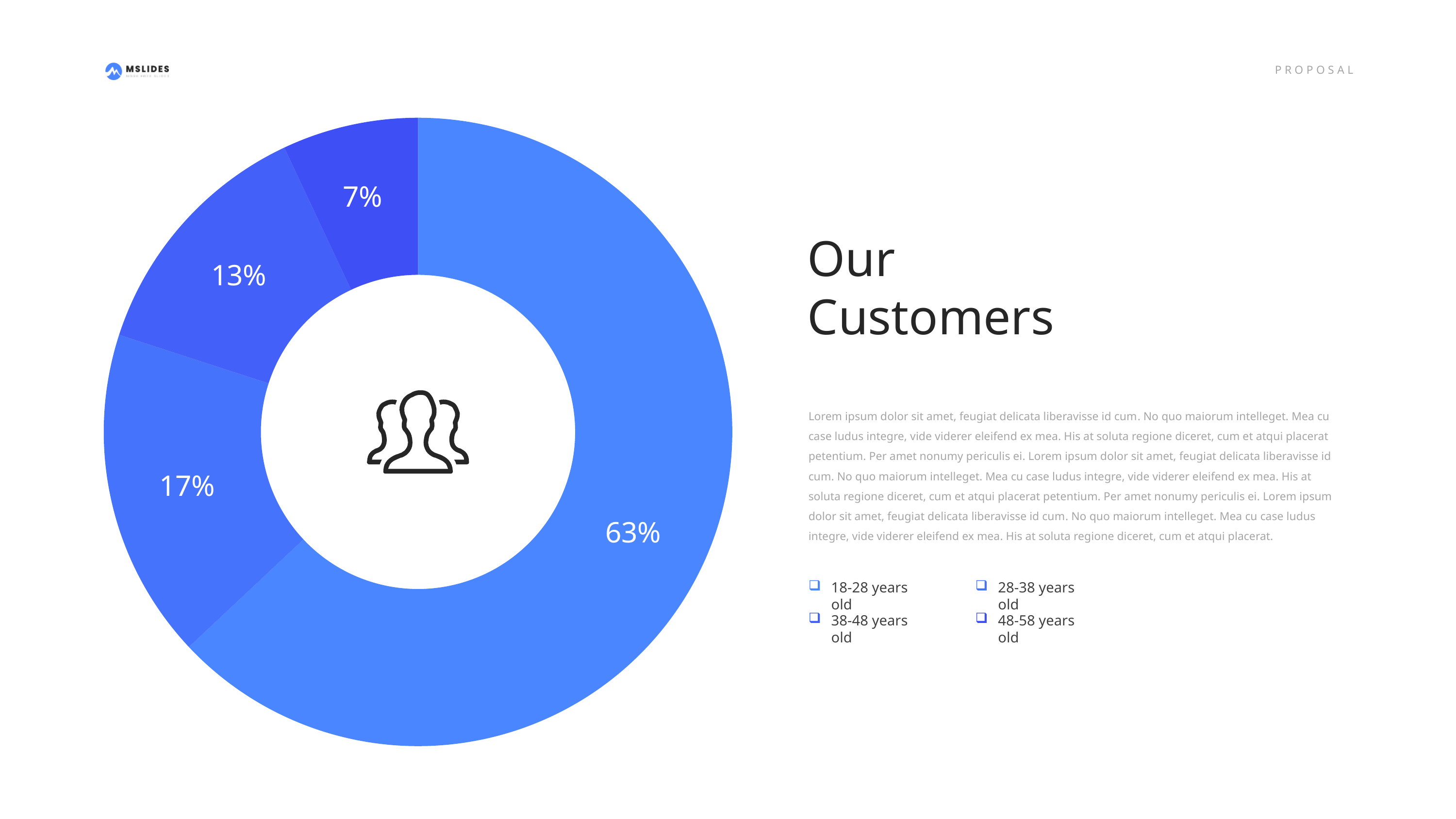
What is the value of the smallest slice in the donut chart? 7% What is the second-largest slice value in the donut chart? 17% What is the title shown next to the donut chart? Our Customers Is the largest slice of the donut chart greater or less than 50%? greater How many age groups are listed in the legend below the text? 4 Which slice is larger, the one labelled 17% or the one labelled 13%? 17% How many slices does the donut chart have? 4 What is the value of the largest slice in the donut chart? 63% What is the difference between the largest slice (63%) and the smallest slice (7%)? 56% What is the difference between the 17% slice and the 13% slice? 4% What do the four slice labels in the donut chart add up to? 100% What type of chart is shown on the slide? pie chart (donut)